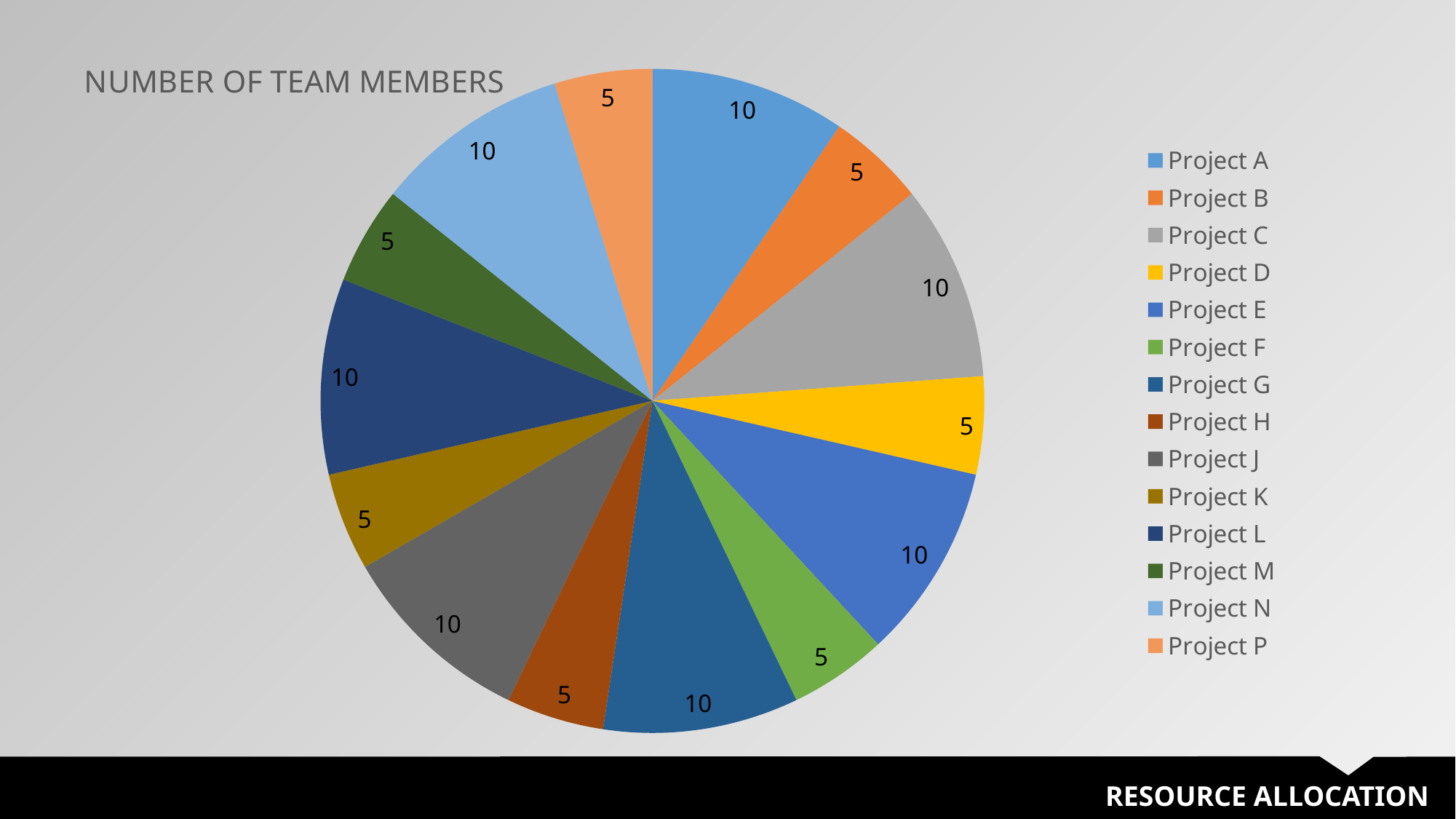
What kind of chart is shown on the slide? pie chart How many team members are allocated to Project H? 5 What is the difference in team members between Project C and Project B? 5 What is the total number of team members across all projects in the pie chart? 105 How many projects (slices) does the pie chart show? 14 How many team members are allocated to Project D? 5 How many team members are allocated to Project A? 10 Which has more team members, Project E or Project F? Project E What colour is the slice for Project D? yellow How many team members are allocated to Project P? 5 What is the title of the chart? NUMBER OF TEAM MEMBERS How many team members are allocated to Project L? 10